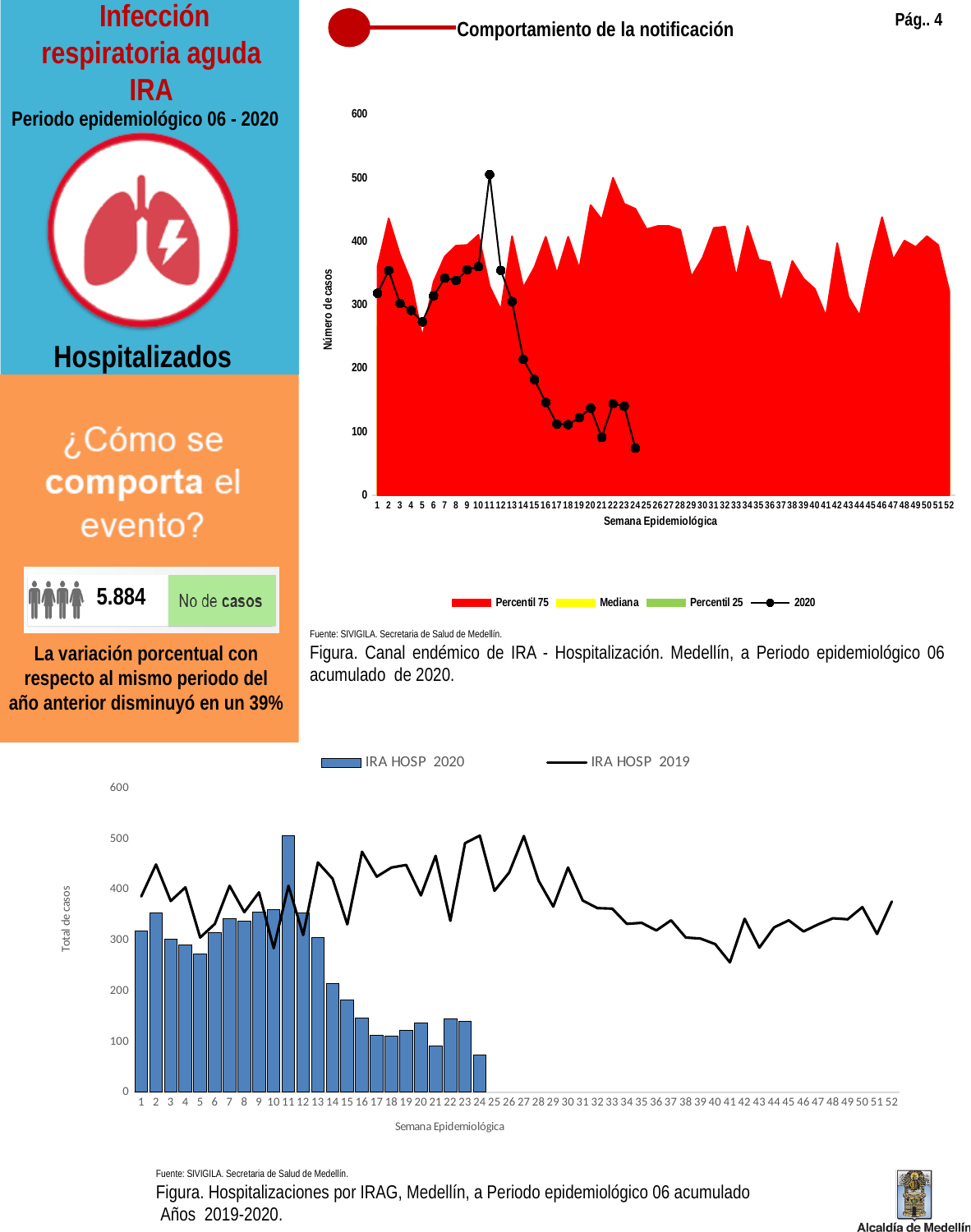
In the bottom chart (Hospitalizaciones por IRAG), which epidemiological week has the tallest IRA HOSP 2020 bar? 11 In the top chart (Canal endémico de IRA - Hospitalización), is the 2020 value for week 24 greater or less than 100? less In the bottom chart (Hospitalizaciones por IRAG), how many series does the legend list? 2 In the top chart (Canal endémico de IRA - Hospitalización), how many entries does the legend list? 4 In the bottom chart (Hospitalizaciones por IRAG), what is the title of the vertical axis? Total de casos In the bottom chart (Hospitalizaciones por IRAG), what kind of chart is used for the IRA HOSP 2020 series? bar chart In the bottom chart (Hospitalizaciones por IRAG), is the IRA HOSP 2020 value for week 15 greater or less than 200? less In the top chart (Canal endémico de IRA - Hospitalización), does the 2020 line rise or fall between week 11 and week 24? fall In the top chart (Canal endémico de IRA - Hospitalización), is the 2020 value for week 11 greater or less than 400? greater In the top chart (Canal endémico de IRA - Hospitalización), in which epidemiological week does the 2020 line reach its lowest value? 24 In the top chart (Canal endémico de IRA - Hospitalización), in which epidemiological week does the 2020 line reach its highest value? 11